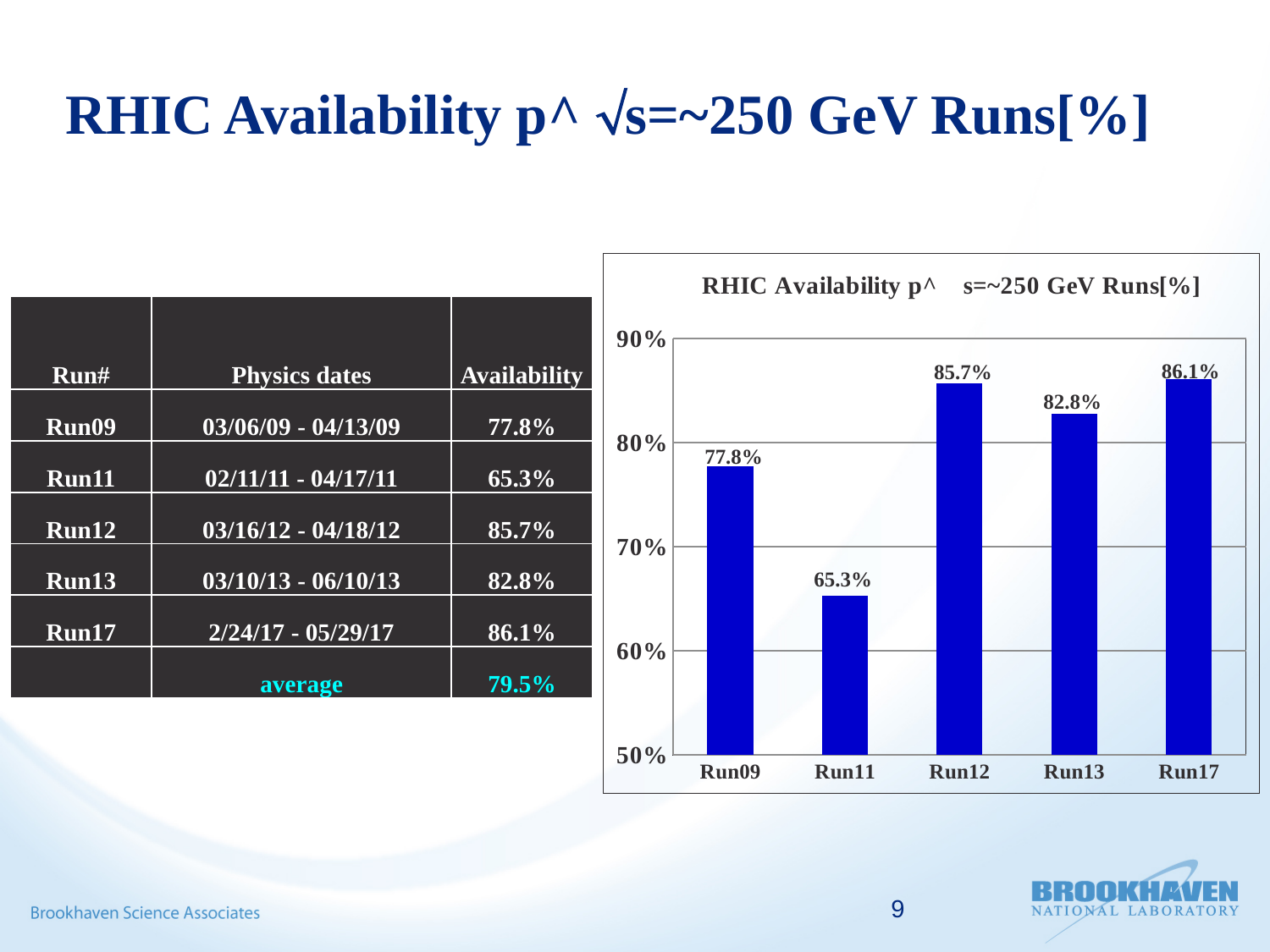
What type of chart is shown on the slide? bar chart What is the availability value shown for Run11 in the chart? 65.3% Is the availability for Run11 greater or less than 70%? less What is the title of the chart? RHIC Availability p^ s=~250 GeV Runs[%] What is the availability value shown for Run13 in the chart? 82.8% What is the difference in availability between Run12 and Run11? 20.4% What is the difference in availability between Run17 and Run13? 3.3% What is the availability value shown for Run09 in the chart? 77.8% How many runs are plotted in the chart? 5 Which has a higher availability, Run09 or Run13? Run13 Which run has the highest availability in the chart? Run17 Which run has the lowest availability in the chart? Run11